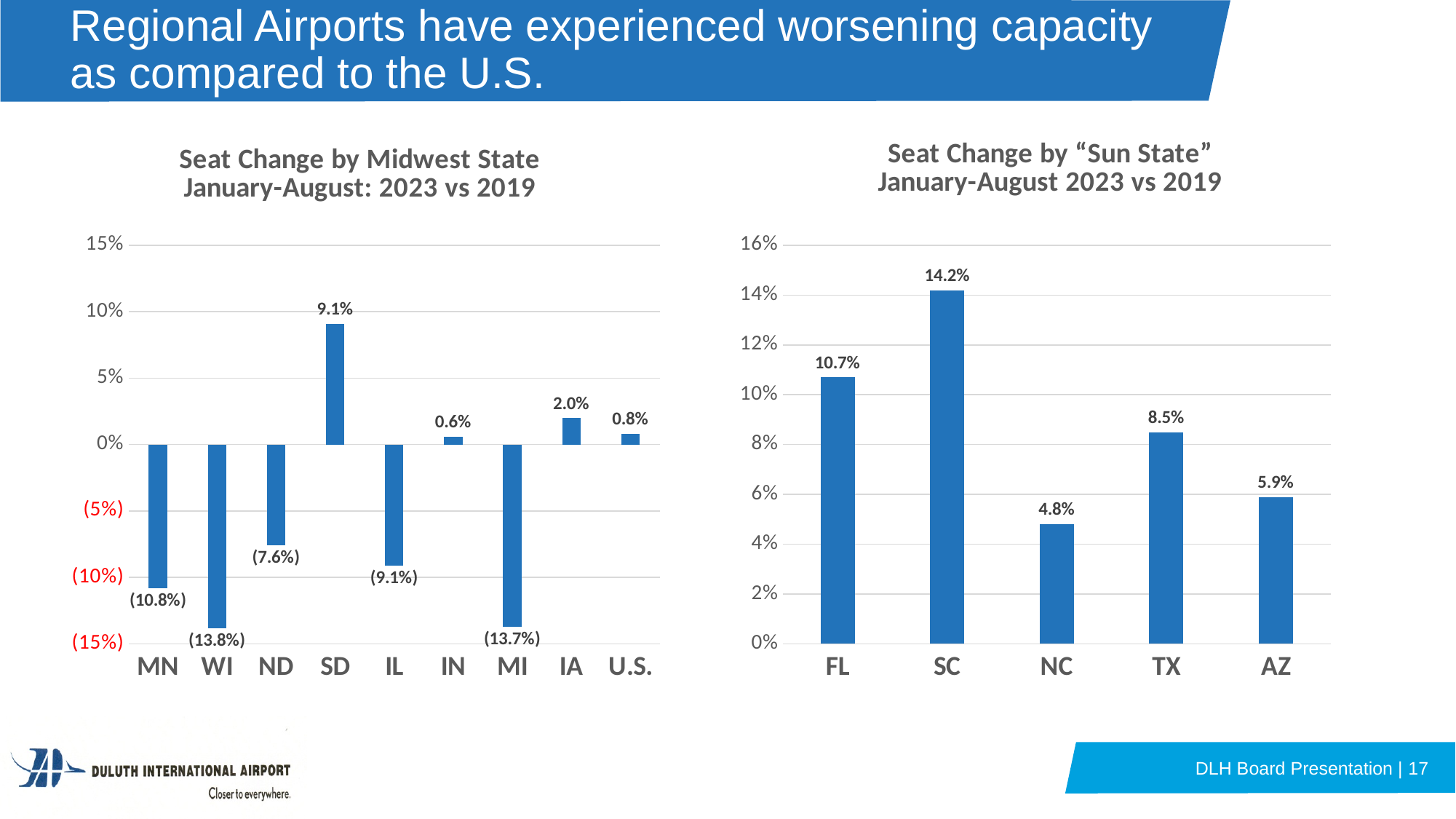
In the Seat Change by Midwest State chart, what is the value for SD? 9.1% In the Seat Change by Midwest State chart, how many categories are shown on the x axis? 9 In the Seat Change by Midwest State chart, what is the value for MN? (10.8%) In the Seat Change by "Sun State" chart, which state has the highest value? SC What kind of chart is the Seat Change by "Sun State" chart? Bar chart In the Seat Change by Midwest State chart, which category has the highest value? SD In the Seat Change by "Sun State" chart, how many states are shown? 5 In the Seat Change by Midwest State chart, what is the value for U.S.? 0.8% In the Seat Change by "Sun State" chart, what is the value for TX? 8.5% In the Seat Change by "Sun State" chart, what is the difference between the values for SC and FL? 3.5% In the Seat Change by Midwest State chart, which is larger, the value for IA or the value for IN? IA In the Seat Change by "Sun State" chart, which state has the lowest value? NC